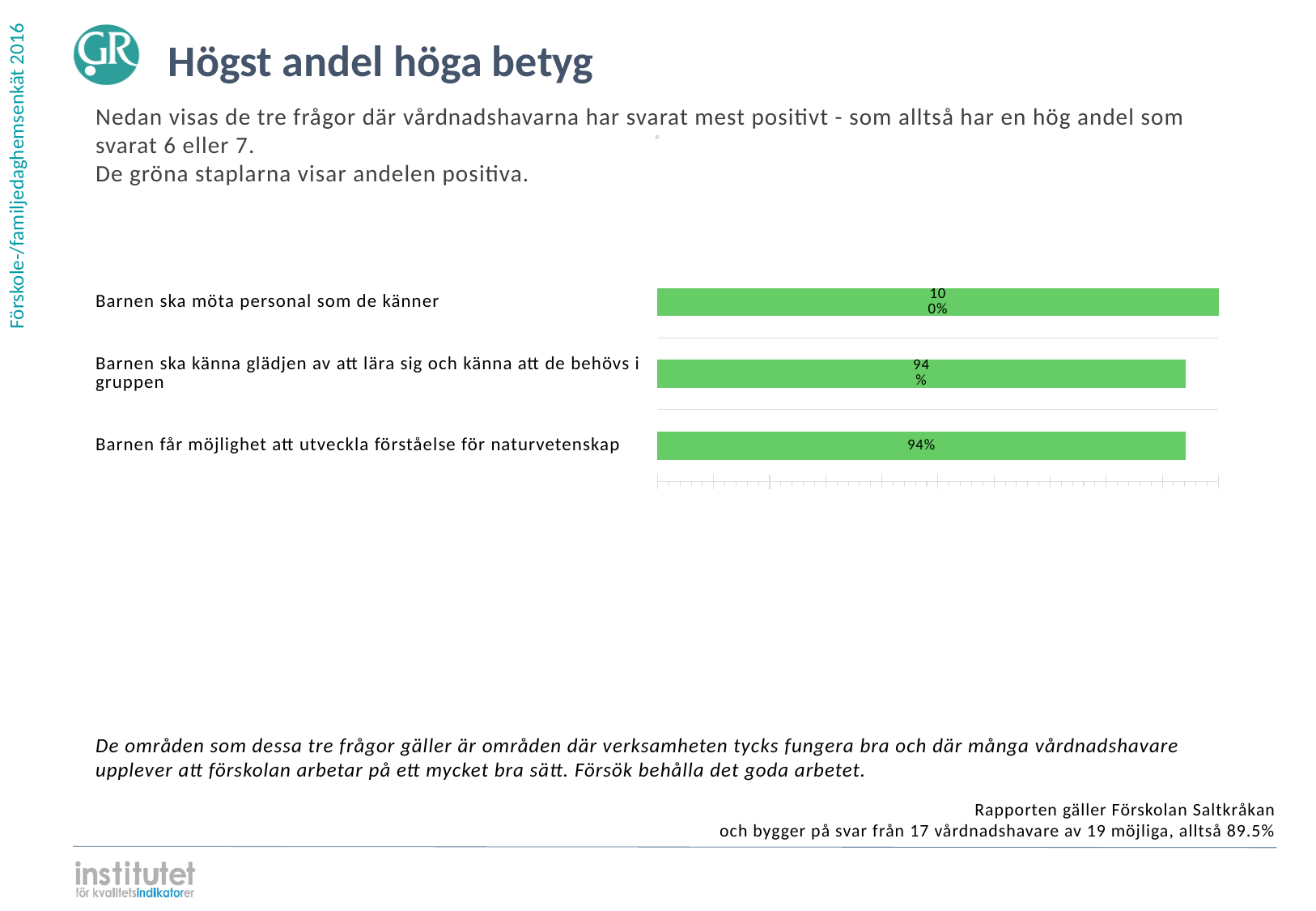
What is the title of the slide containing the chart? Högst andel höga betyg Which is larger: the value for "Barnen ska möta personal som de känner" or the value for "Barnen ska känna glädjen av att lära sig och känna att de behövs i gruppen"? Barnen ska möta personal som de känner What is the value for "Barnen ska möta personal som de känner"? 100% What colour are the bars in the chart? Green What is the difference between the value for "Barnen ska möta personal som de känner" and the value for "Barnen får möjlighet att utveckla förståelse för naturvetenskap"? 6 percentage points Which category has the highest value in the chart? Barnen ska möta personal som de känner How many categories are shown in the chart? 3 What is the value for "Barnen får möjlighet att utveckla förståelse för naturvetenskap"? 94% Do the values for "Barnen ska känna glädjen av att lära sig och känna att de behövs i gruppen" and "Barnen får möjlighet att utveckla förståelse för naturvetenskap" have the same value? Yes, both 94% What kind of chart is shown on the slide? Bar chart What is the value for "Barnen ska känna glädjen av att lära sig och känna att de behövs i gruppen"? 94%